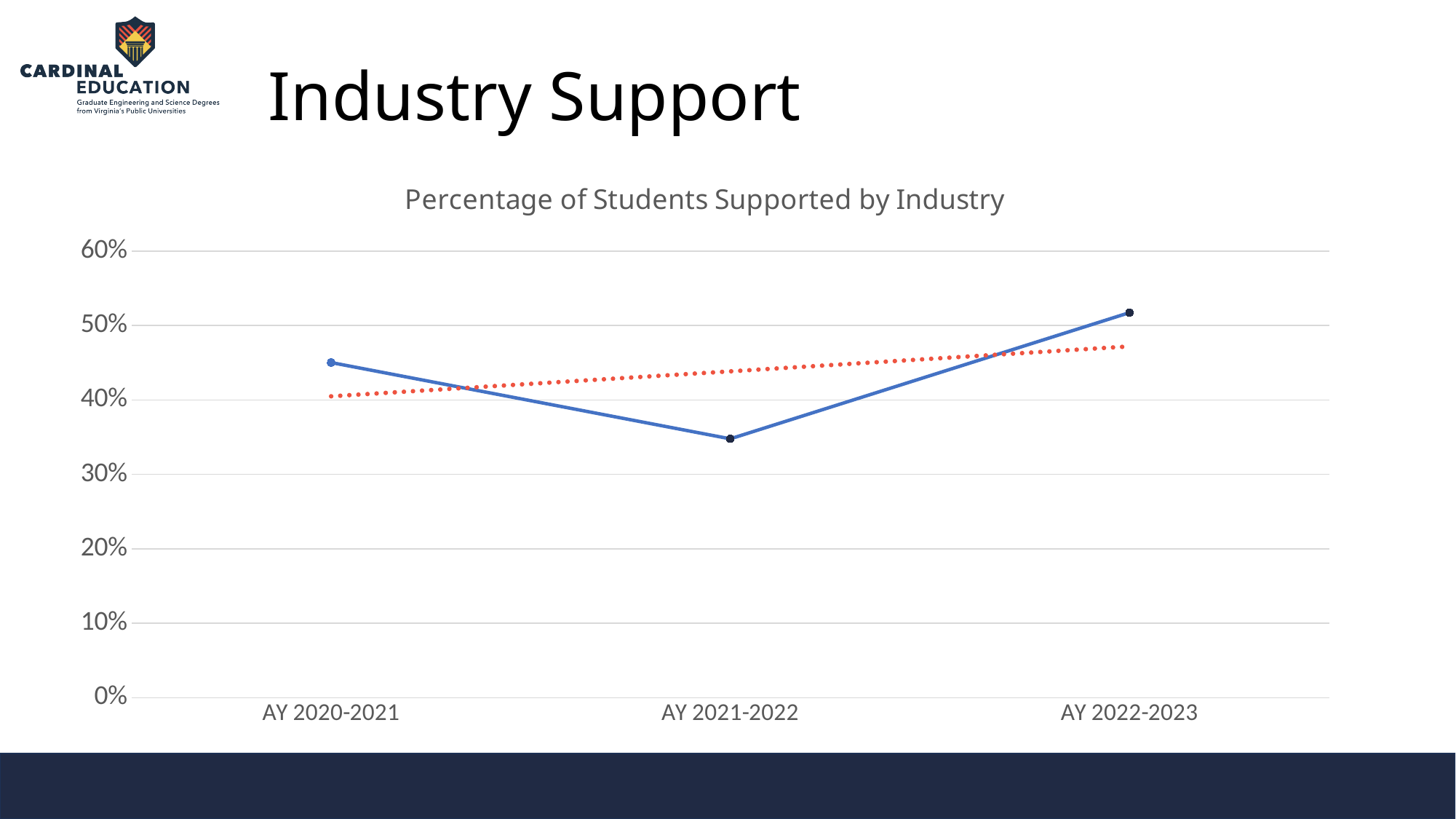
Which is larger, the value for AY 2020-2021 or the value for AY 2021-2022? AY 2020-2021 Is the value for AY 2021-2022 greater or less than 40%? less How many academic years are plotted on the x axis? 3 Is the value for AY 2022-2023 greater or less than 50%? greater Which academic year has the lowest percentage of students supported by industry? AY 2021-2022 Is the value for AY 2020-2021 greater or less than 40%? greater What is the title of the chart? Percentage of Students Supported by Industry Which academic year has the highest percentage of students supported by industry? AY 2022-2023 Does the percentage rise or fall from AY 2021-2022 to AY 2022-2023? rise What kind of chart is shown on the slide? line chart